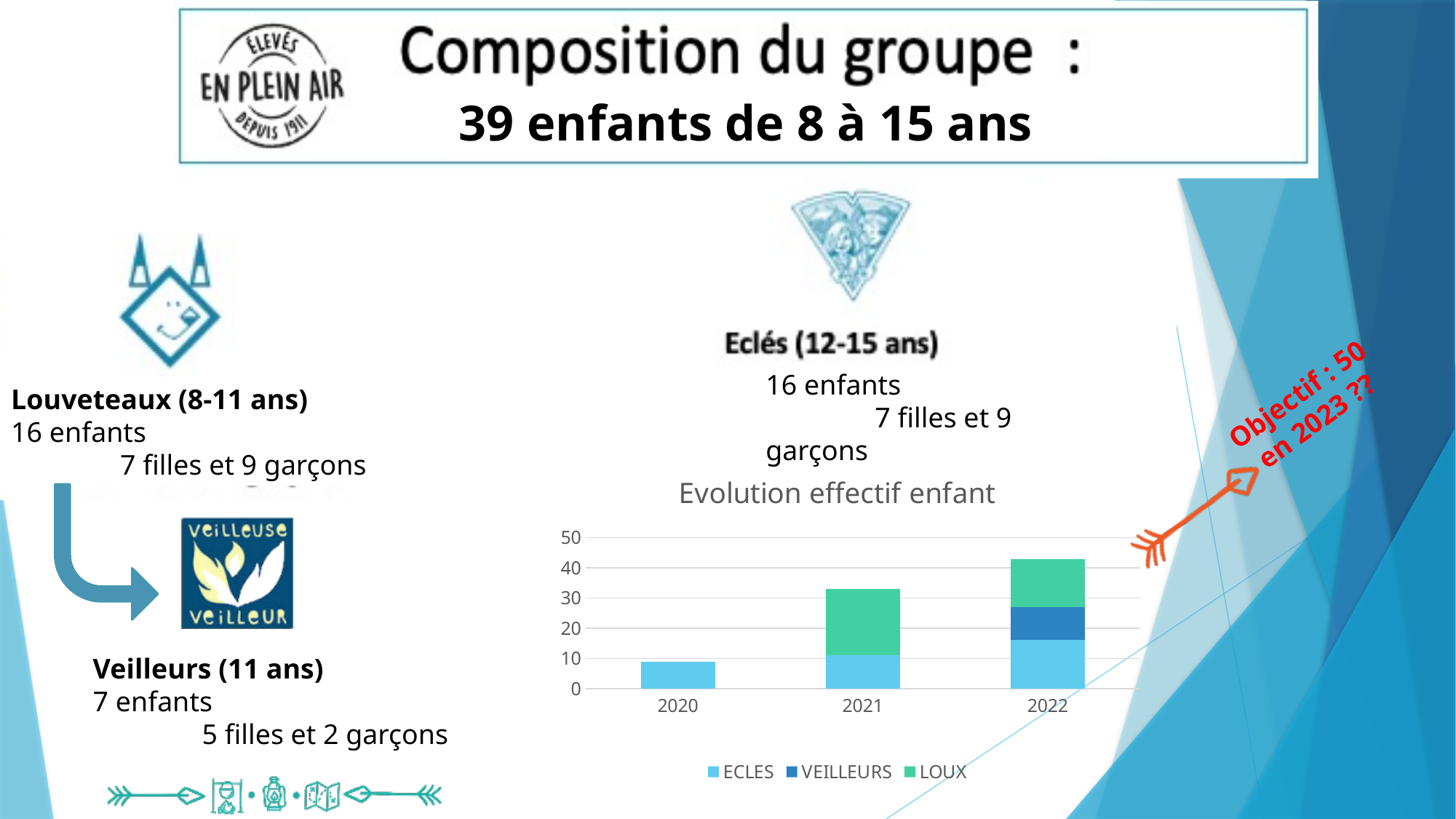
What kind of chart is shown on the slide? bar chart Which series are listed in the chart legend? ECLES, VEILLEURS, LOUX Is the total bar for 2022 greater or less than 40? greater Which year has the larger total bar, 2020 or 2021? 2021 Which year has the highest total bar in the chart? 2022 Is the total bar for 2021 greater or less than 30? greater How many series does the chart legend list? 3 Which year has the lowest total bar in the chart? 2020 What is the title of the chart? Evolution effectif enfant Is the total bar for 2022 greater or less than 50? less How many years are shown on the x axis of the chart? 3 Do the total bar heights rise or fall from 2020 to 2022? rise